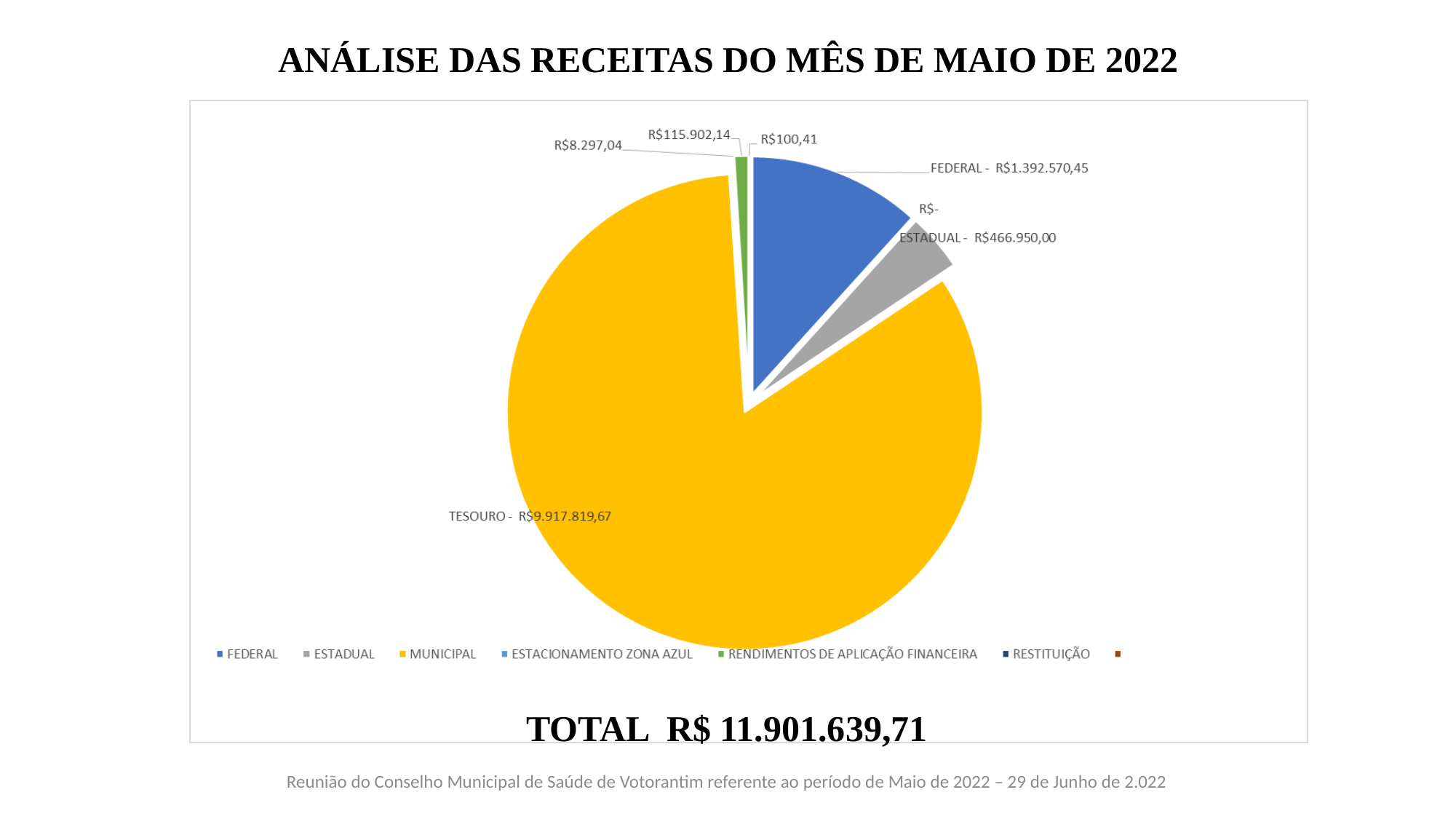
Which category has the largest slice of the pie? MUNICIPAL (TESOURO) What colour is the MUNICIPAL slice in the pie chart? yellow What is the value shown for FEDERAL? R$1.392.570,45 What kind of chart is shown on the slide? pie chart Which is larger, the FEDERAL value or the ESTADUAL value? FEDERAL What is the value shown for ESTADUAL? R$466.950,00 What total is printed below the pie chart? R$ 11.901.639,71 What is the value shown for TESOURO? R$9.917.819,67 What is the title of the chart on the slide? ANÁLISE DAS RECEITAS DO MÊS DE MAIO DE 2022 What is the difference between the FEDERAL value and the ESTADUAL value? R$925.620,45